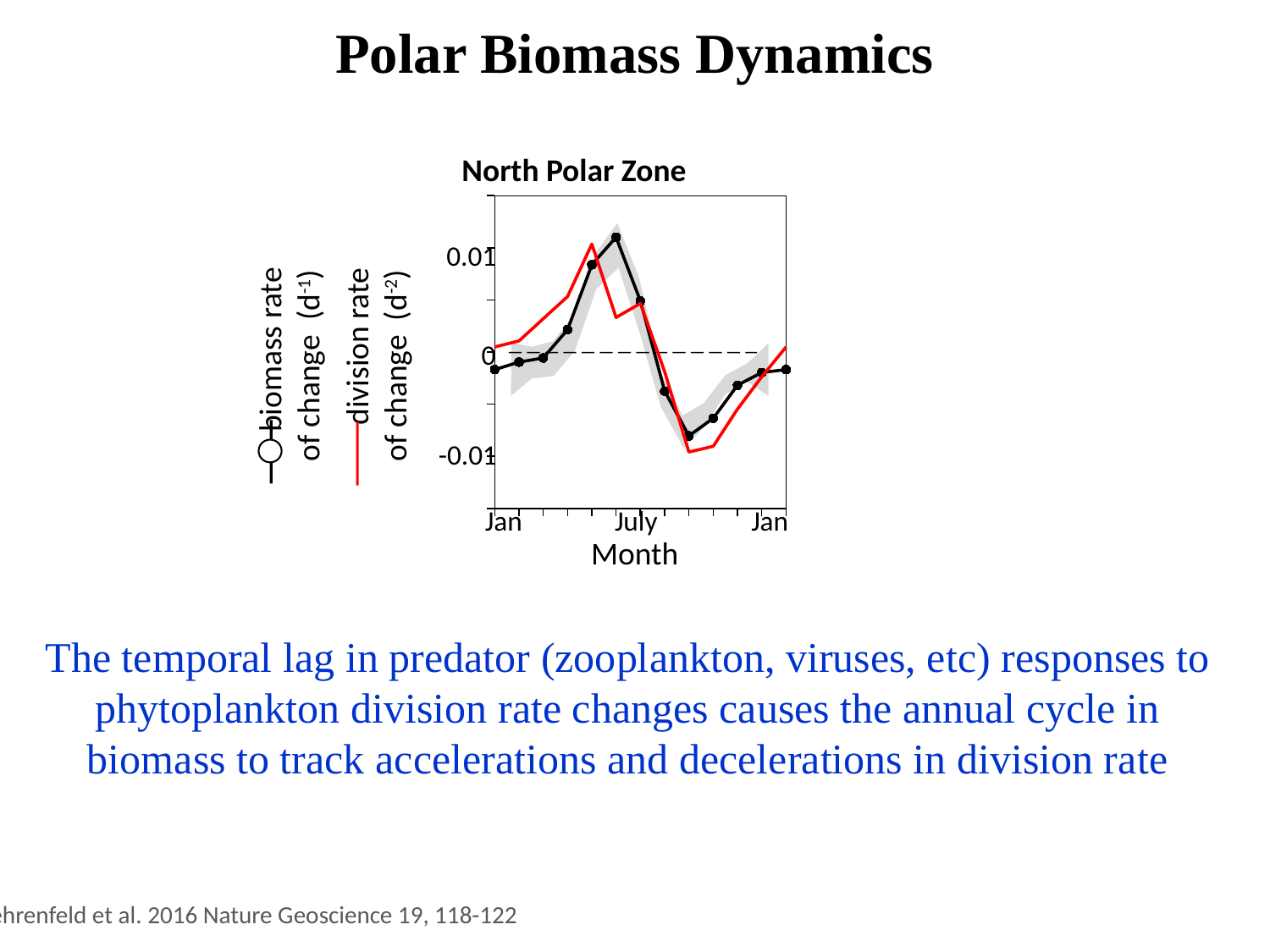
What kind of chart is shown on the slide? line chart Does the biomass rate of change rise or fall between Jan and July? rise Is the lowest value of the division rate of change series greater or less than 0? less Is the lowest value of the biomass rate of change series greater or less than 0? less What is the title of the chart? North Polar Zone Is the peak value of the biomass rate of change series greater or less than 0? greater What is the label of the x axis? Month Which series is drawn in red? division rate of change How many series does the chart's legend list? 2 Does the biomass rate of change rise or fall in the months immediately after July? fall Around which labelled month does the biomass rate of change reach its highest value? July